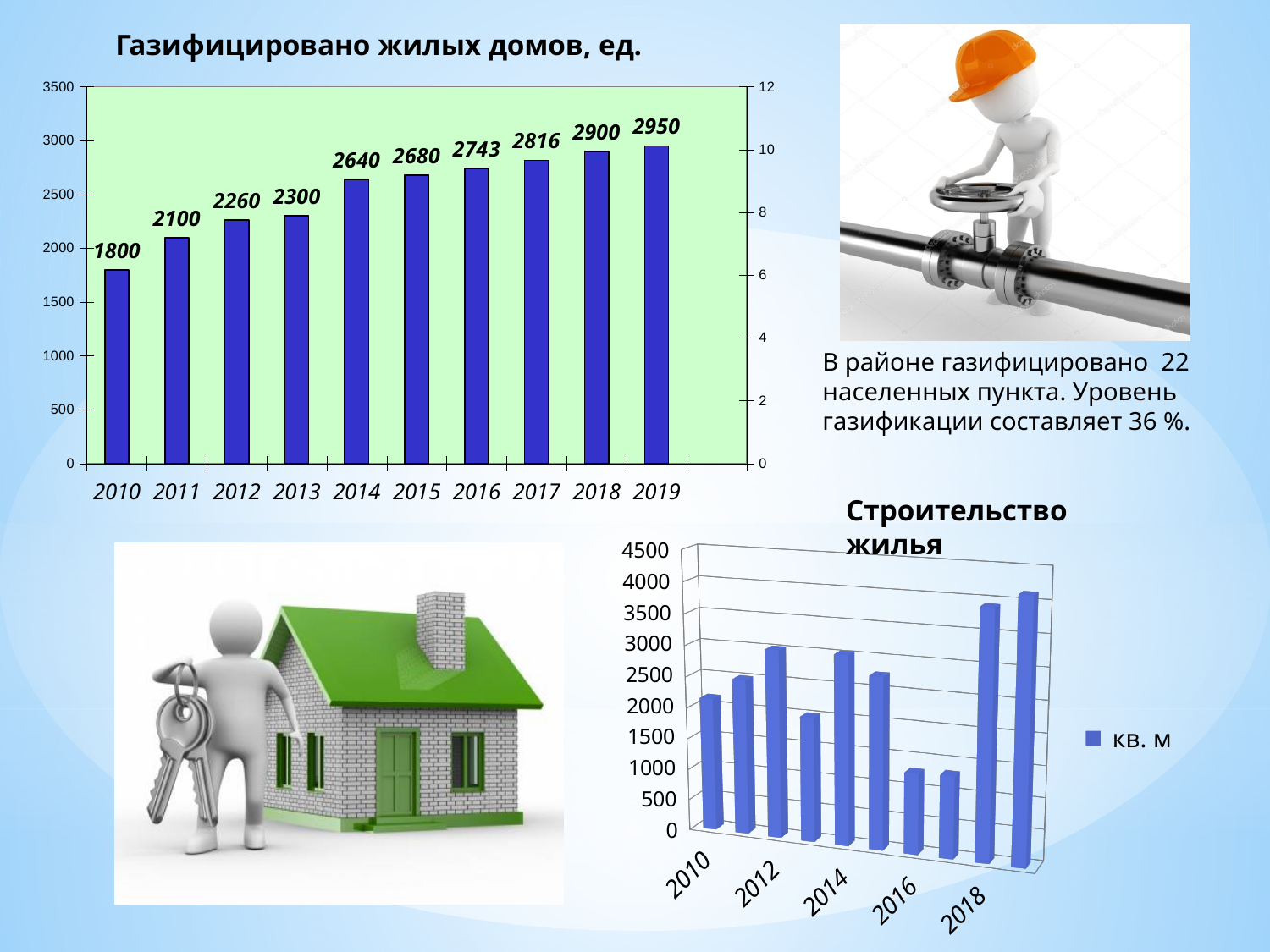
In the chart 'Газифицировано жилых домов, ед.', which year has the highest value? 2019 In the chart 'Газифицировано жилых домов, ед.', how many years are shown on the x axis? 10 In the chart 'Газифицировано жилых домов, ед.', which year has the lowest value? 2010 In the chart 'Газифицировано жилых домов, ед.', which is larger, the value for 2012 or the value for 2013? 2013 In the chart 'Газифицировано жилых домов, ед.', what is the difference between the values for 2019 and 2010? 1150 In the chart 'Строительство жилья', is the value for 2018 greater or less than 3000? greater In the chart 'Строительство жилья', is the value for 2012 greater or less than 2500? greater What kind of chart is 'Строительство жилья'? bar chart In the chart 'Газифицировано жилых домов, ед.', what is the value for 2014? 2640 In the chart 'Строительство жилья', what series name does the legend show? кв. м In the chart 'Газифицировано жилых домов, ед.', what is the value for 2017? 2816 In the chart 'Газифицировано жилых домов, ед.', do the values rise or fall from 2010 to 2019? rise